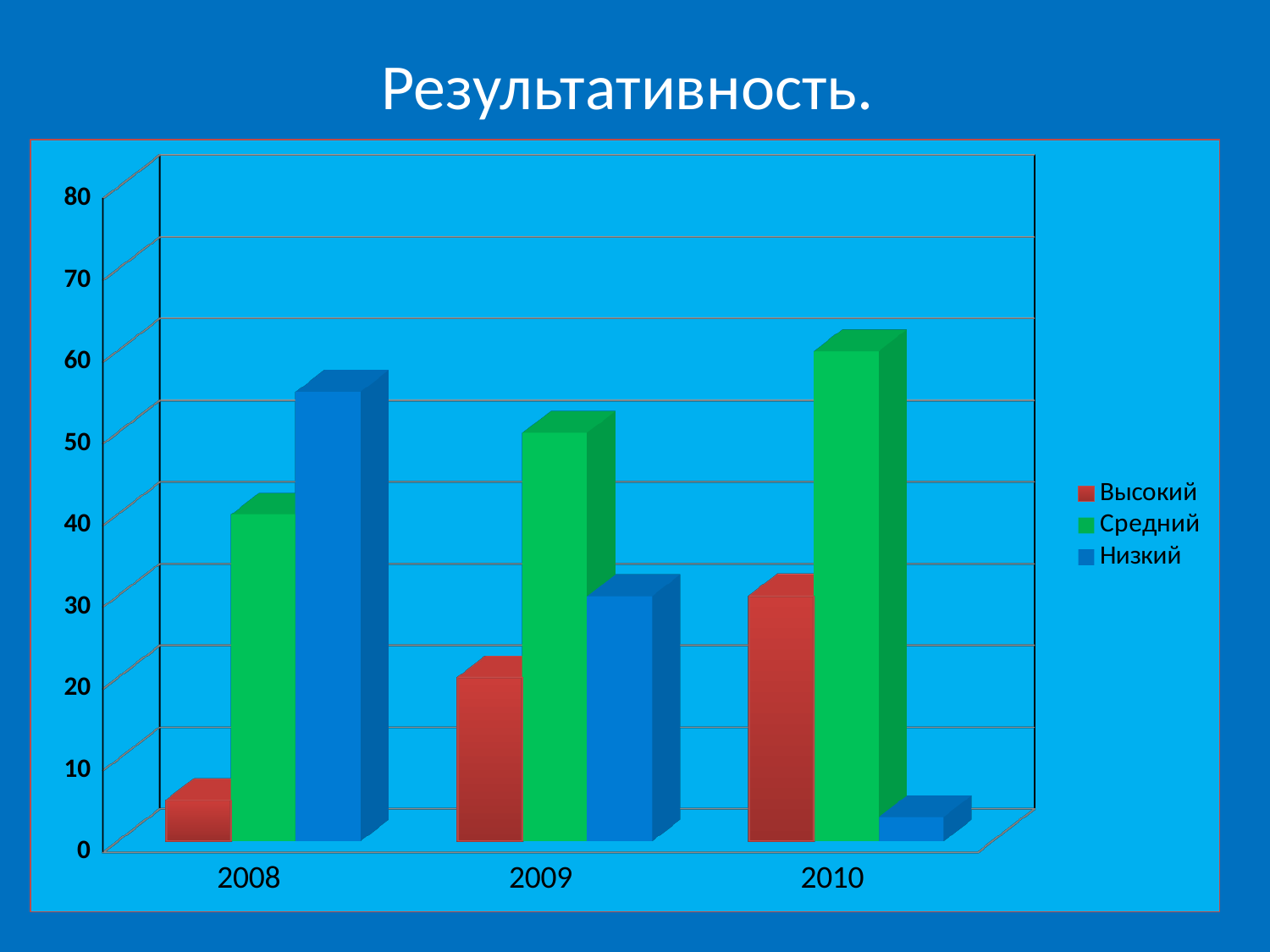
Does the value for Высокий rise or fall from 2008 to 2010? rise Is the value for Низкий in 2008 greater or less than 50? greater Which series is shown in green in the legend? Средний What is the title of the chart? Результативность. Which year has the lowest value for Низкий? 2010 Is the value for Низкий in 2010 greater or less than 10? less Is the value for Высокий in 2008 greater or less than 10? less How many years are shown on the x axis? 3 What kind of chart is shown on the slide? bar chart How many series does the legend list? 3 Which year has the highest value for Высокий? 2010